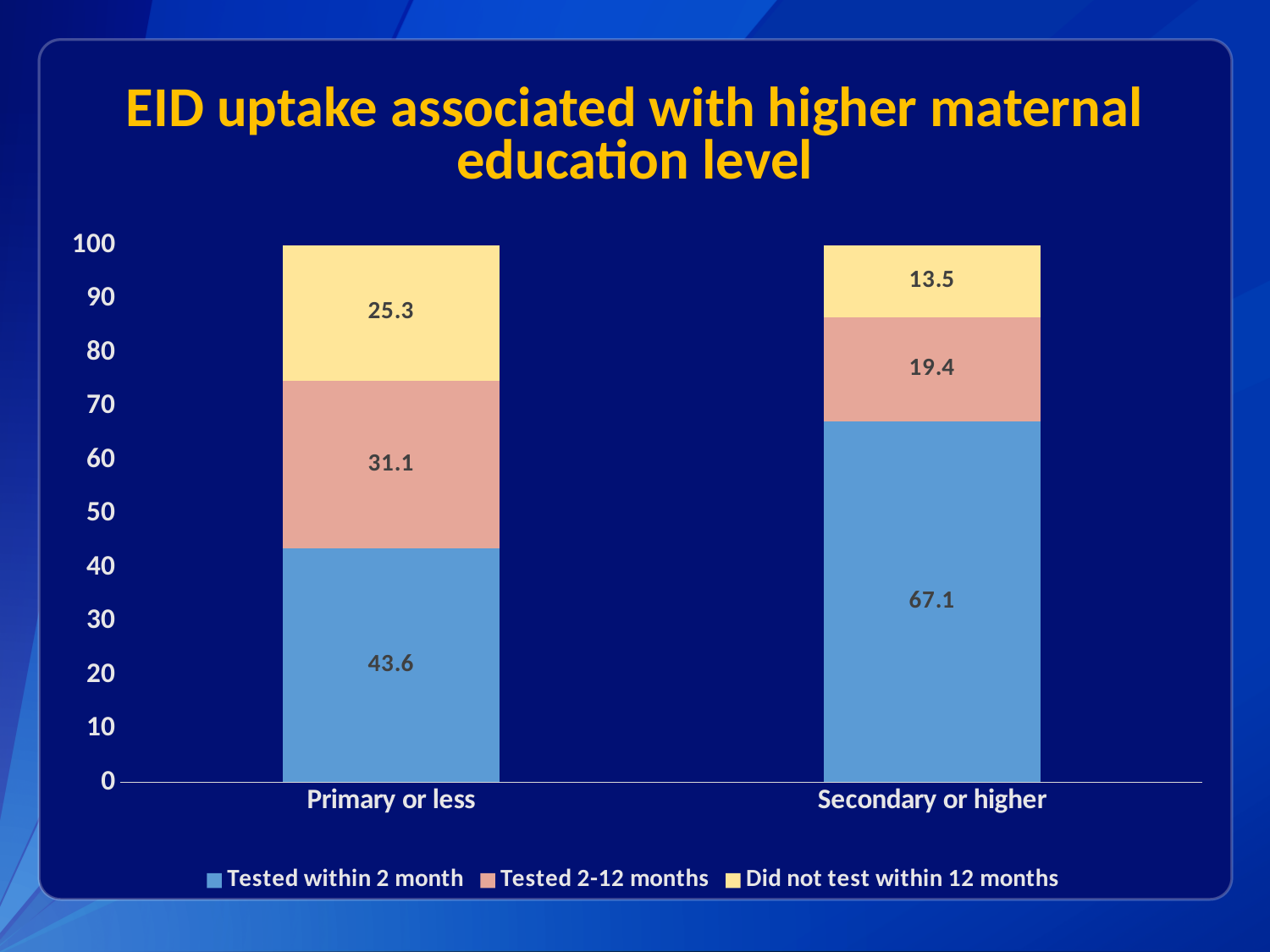
What is the value for "Tested within 2 month" in the "Secondary or higher" category? 67.1 What is the value for "Tested 2-12 months" in the "Secondary or higher" category? 19.4 Which category has the higher value for "Tested within 2 month"? Secondary or higher What is the value for "Did not test within 12 months" in the "Primary or less" category? 25.3 Is the "Tested 2-12 months" value larger for "Primary or less" or for "Secondary or higher"? Primary or less Which category has the lower value for "Did not test within 12 months"? Secondary or higher What kind of chart is shown on the slide? Stacked bar chart How many categories are shown on the x axis? 2 What is the difference between the "Tested within 2 month" values for "Secondary or higher" and "Primary or less"? 23.5 What is the value for "Tested within 2 month" in the "Primary or less" category? 43.6 What is the total of the stacked bar for "Primary or less"? 100 How many series does the legend list? 3